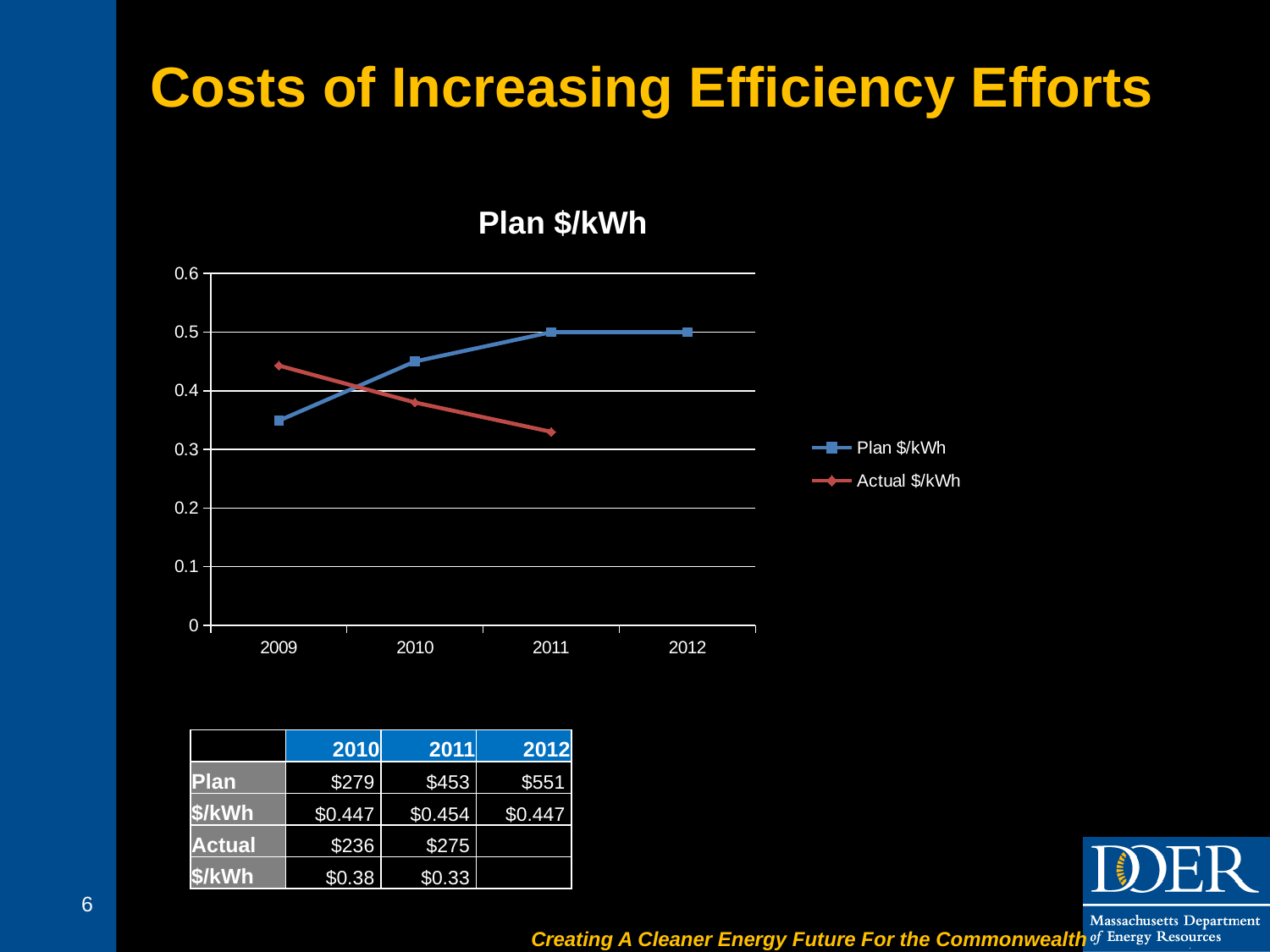
What is the title of the chart? Plan $/kWh Which series is drawn with red diamond markers? Actual $/kWh Does the Actual $/kWh series rise or fall from 2009 to 2011? fall How many years are shown along the x axis of the chart? 4 In which year is the Actual $/kWh series at its highest? 2009 In 2011, which series has the larger value, Plan $/kWh or Actual $/kWh? Plan $/kWh How many series does the chart's legend list? 2 What kind of chart is shown on the slide? line chart Is the Actual $/kWh value for 2009 greater or less than 0.4? greater Is the Plan $/kWh value for 2009 greater or less than 0.4? less Does the Plan $/kWh series rise or fall from 2009 to 2011? rise Is the Actual $/kWh value for 2011 greater or less than 0.4? less